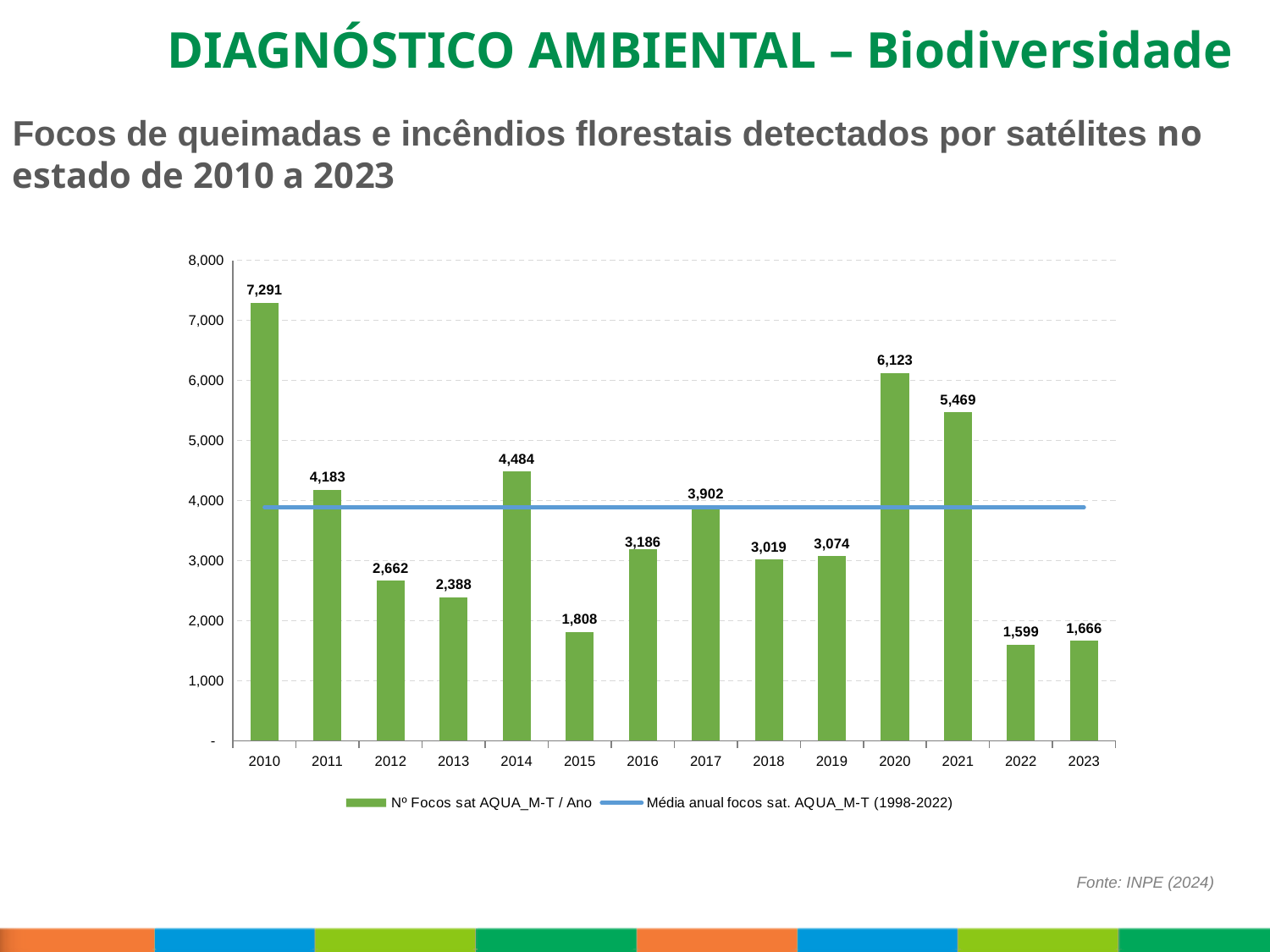
How many series does the chart legend list? 2 What kind of chart is used to show the number of fire hotspots per year? Bar chart How many years are shown on the x axis of the chart? 14 Which year has the highest number of fire hotspots? 2010 Which year has more fire hotspots, 2014 or 2017? 2014 Is the value for 2016 greater or less than 3,000? greater What is the number of fire hotspots for 2015? 1,808 What is the number of fire hotspots (Nº Focos sat AQUA_M-T) for 2010? 7,291 What is the difference between the number of fire hotspots in 2020 and 2021? 654 Which year has the lowest number of fire hotspots? 2022 What is the number of fire hotspots for 2020? 6,123 What does the blue horizontal line in the chart represent, according to the legend? Média anual focos sat. AQUA_M-T (1998-2022)